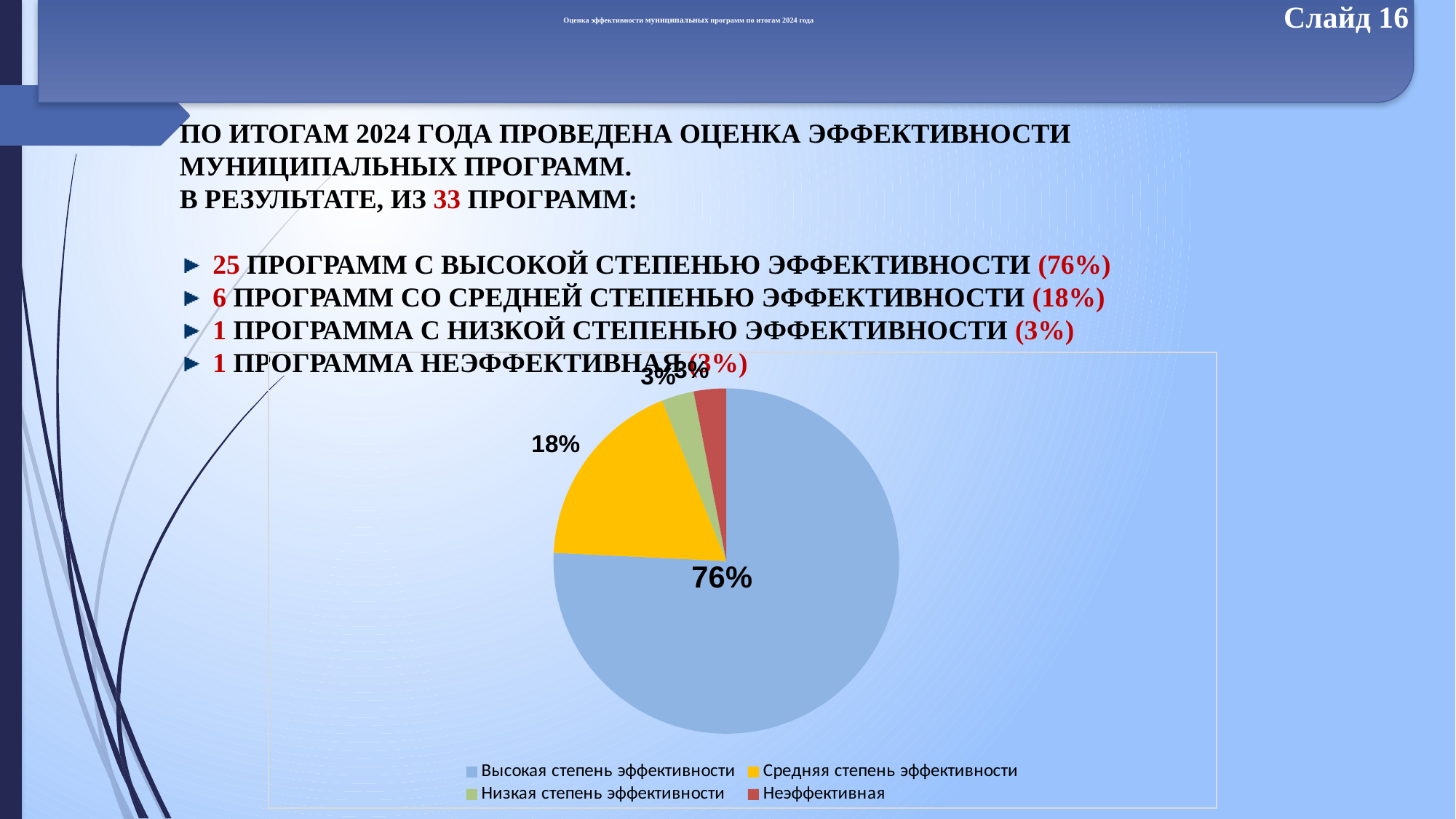
Which category has the largest slice of the pie? Высокая степень эффективности What share of the pie does "Низкая степень эффективности" take? 3% What colour is the "Средняя степень эффективности" slice? Yellow What kind of chart is shown on the slide? Pie chart What share of the pie does "Высокая степень эффективности" take? 76% What share of the pie does "Средняя степень эффективности" take? 18% What colour is the "Неэффективная" slice? Red How many entries does the legend list? 4 Which slice is larger: "Средняя степень эффективности" or "Неэффективная"? Средняя степень эффективности How many slices does the pie chart have? 4 What is the difference in percentage points between the "Высокая степень эффективности" slice and the "Средняя степень эффективности" slice? 58